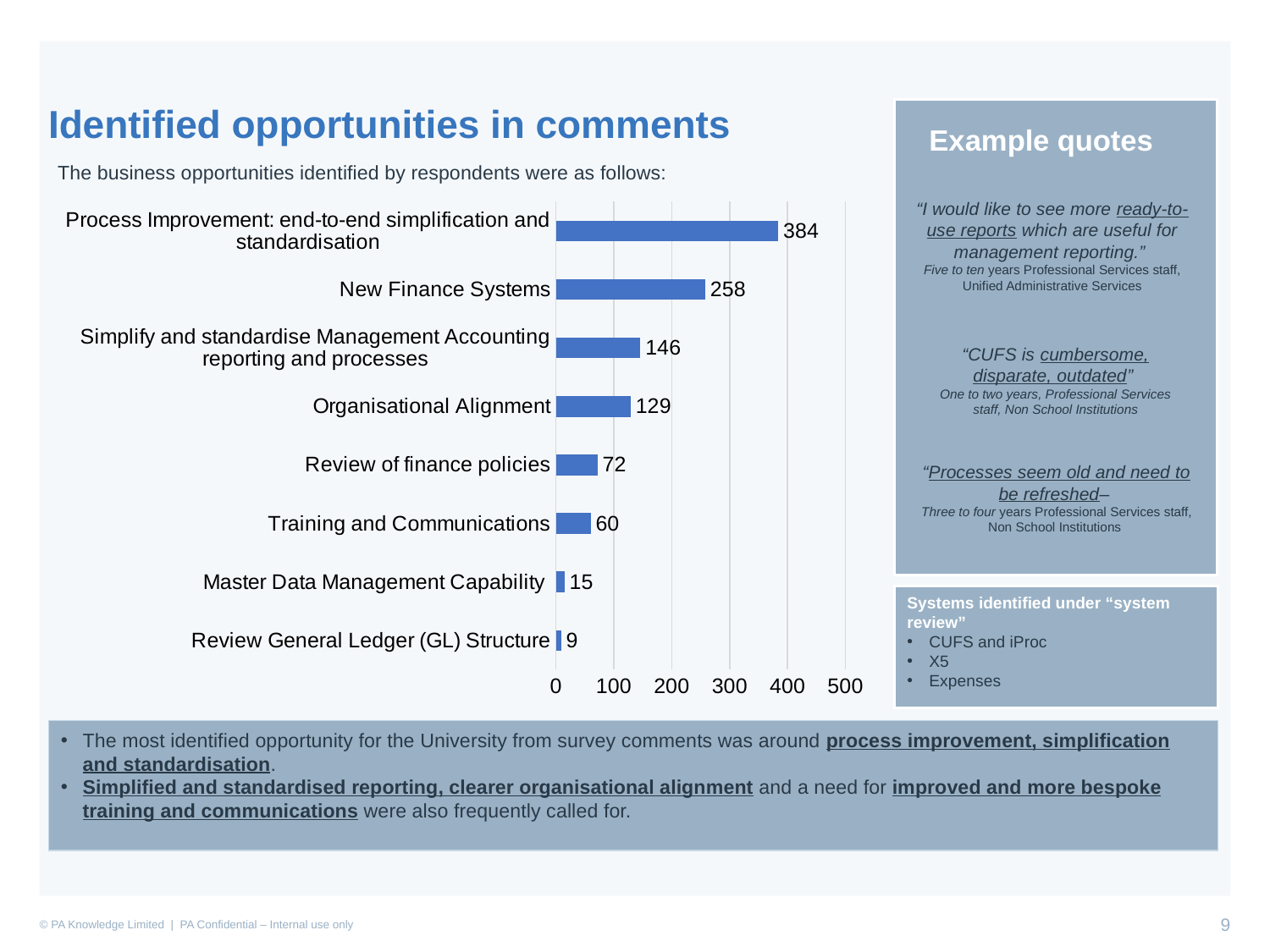
Which category has the highest value? Process Improvement: end-to-end simplification and standardisation Which is larger: the value for Simplify and standardise Management Accounting reporting and processes or the value for Organisational Alignment? Simplify and standardise Management Accounting reporting and processes What is the difference between the values for Process Improvement: end-to-end simplification and standardisation and New Finance Systems? 126 Is the value for New Finance Systems greater or less than 200? greater What is the highest value shown on the chart's horizontal axis? 500 Which category has the lowest value? Review General Ledger (GL) Structure What value is shown for New Finance Systems? 258 What value is shown for Master Data Management Capability? 15 What is the difference between the values for Review of finance policies and Training and Communications? 12 What kind of chart is shown on the slide? Bar chart What value is shown for Organisational Alignment? 129 How many categories are shown in the chart? 8